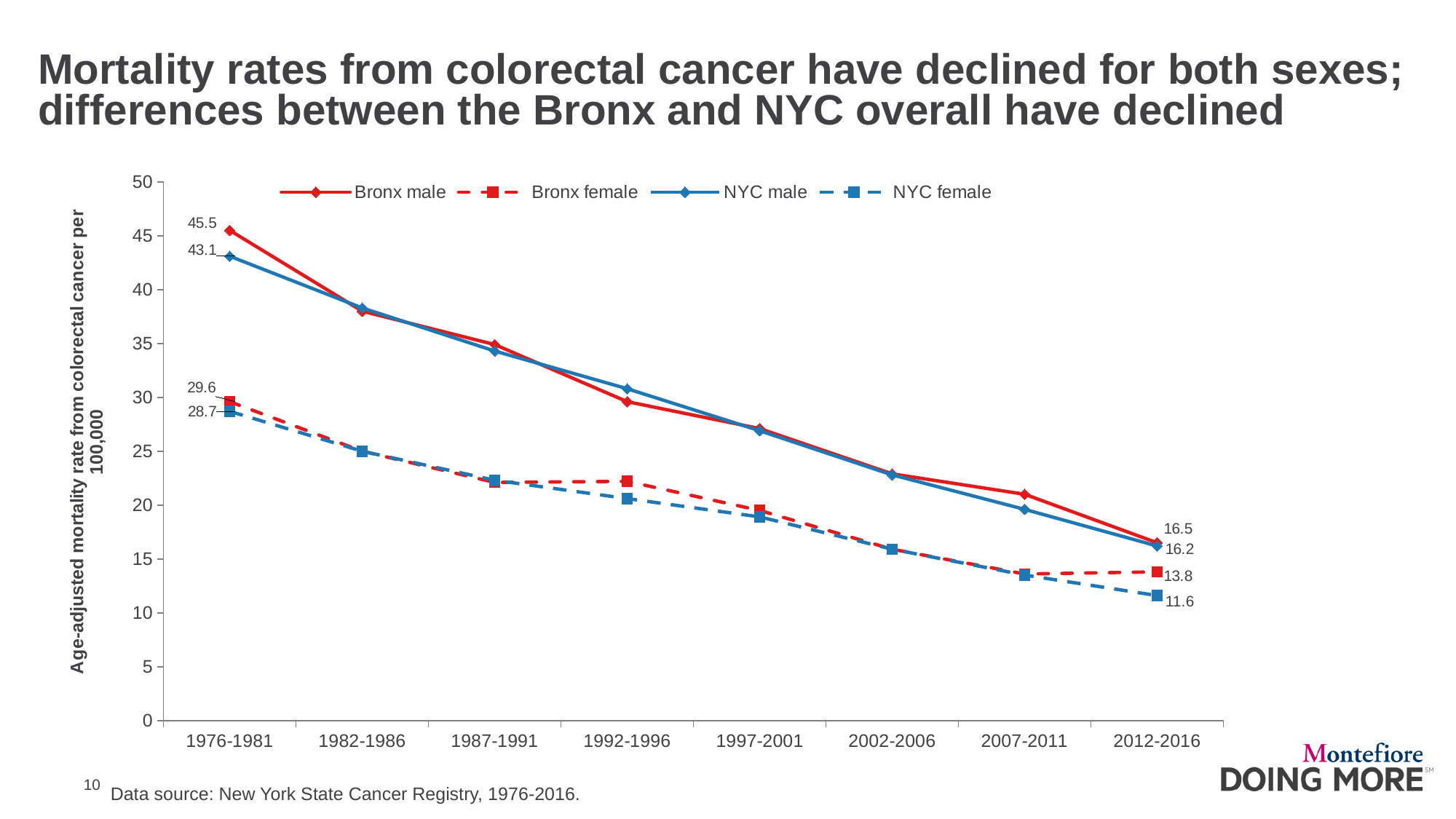
How many time periods are shown on the x axis? 8 How many series does the legend list? 4 What is the difference between the Bronx female and NYC female rates in 2012-2016? 2.2 What is the NYC male mortality rate for 2012-2016? 16.2 What is the Bronx female mortality rate for 1976-1981? 29.6 What type of chart is shown on the slide? line chart What is the Bronx male mortality rate for 1976-1981? 45.5 What is the difference between the Bronx male and NYC male rates in 1976-1981? 2.4 What is the NYC female mortality rate for 2012-2016? 11.6 Which series has the highest value in 1976-1981? Bronx male Do the Bronx male values rise or fall from 1976-1981 to 2012-2016? fall Is the NYC female value for 1992-1996 greater or less than 25? less